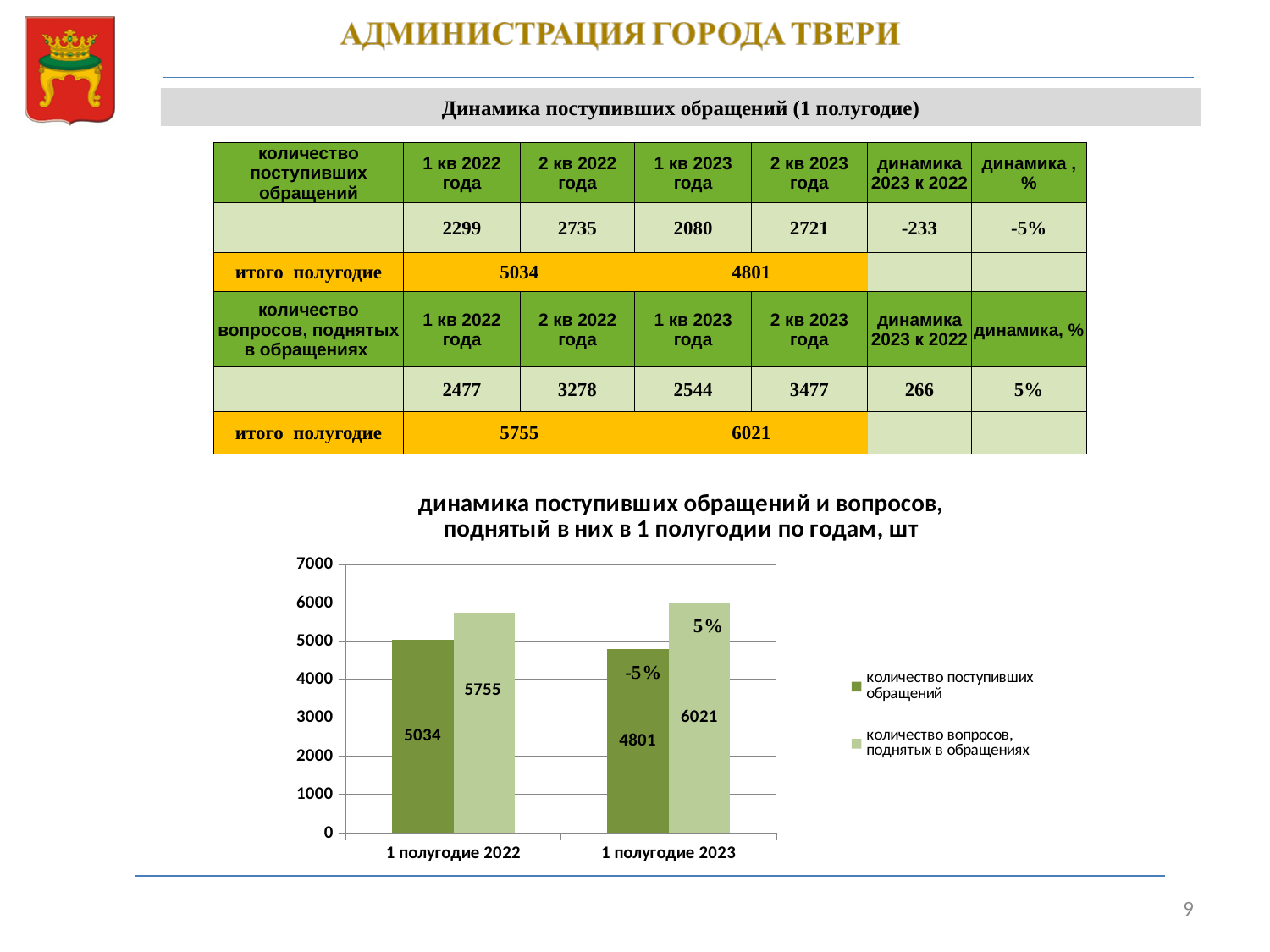
What is the value for "количество вопросов, поднятых в обращениях" in 1 полугодие 2023? 6021 Which series has the higher value in 1 полугодие 2023? количество вопросов, поднятых в обращениях What is the value for "количество поступивших обращений" in 1 полугодие 2023? 4801 What is the value for "количество вопросов, поднятых в обращениях" in 1 полугодие 2022? 5755 What is the title of the chart? динамика поступивших обращений и вопросов, поднятый в них в 1 полугодии по годам, шт What type of chart is shown on the slide? bar chart Does the value for "количество поступивших обращений" rise or fall from 1 полугодие 2022 to 1 полугодие 2023? fall How many categories are shown on the x axis? 2 By how much did "количество поступивших обращений" change from 1 полугодие 2022 to 1 полугодие 2023? -233 How many series does the legend list? 2 What is the value for "количество поступивших обращений" in 1 полугодие 2022? 5034 What is the difference between the two series' values in 1 полугодие 2022? 721